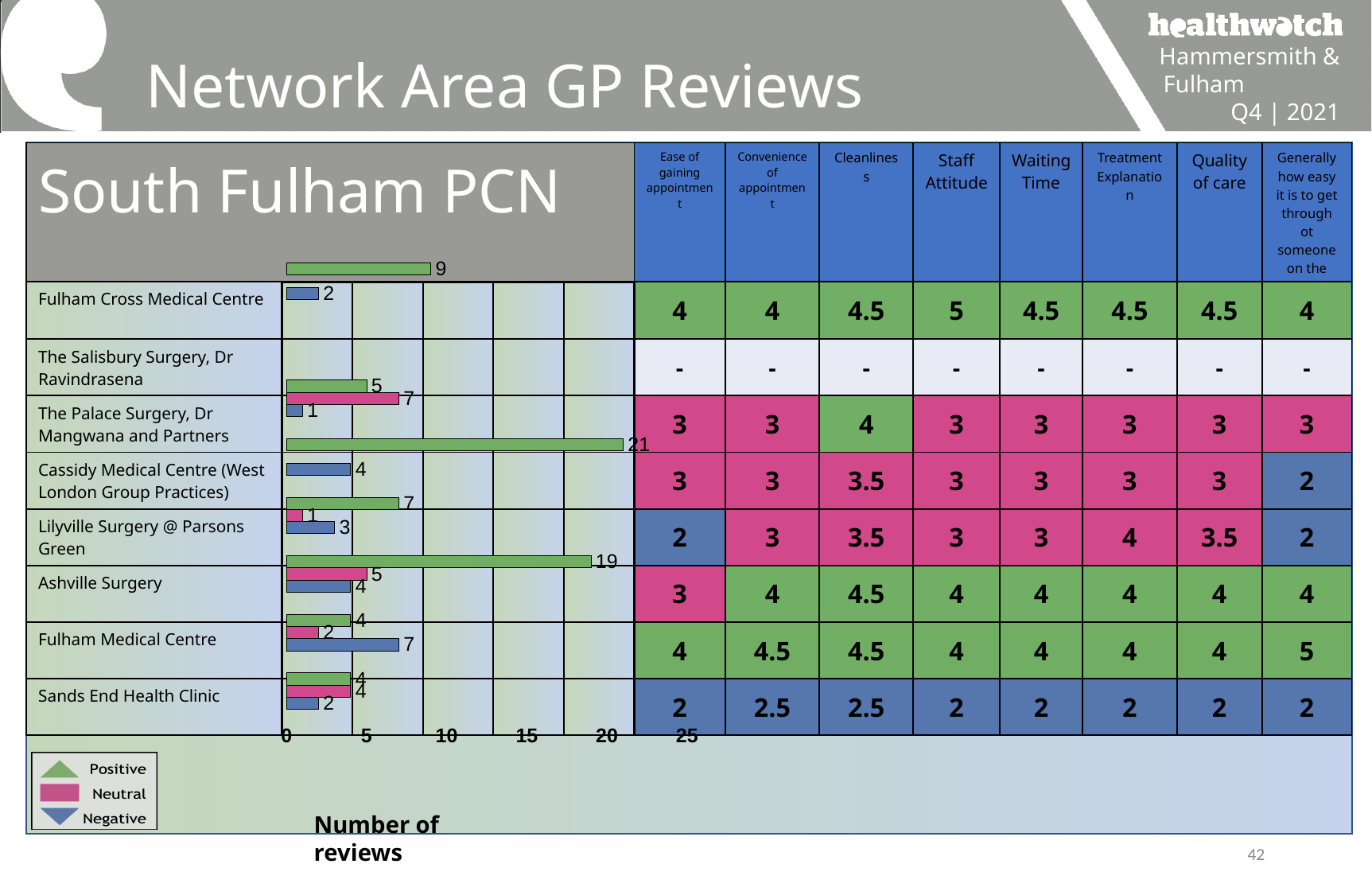
What is the difference between the two longest Positive bars, labelled 21 and 19? 2 What is the highest tick value shown on the horizontal axis of the bar chart? 25 Is the longest bar in the chart greater or less than 20? greater What is the largest value labelled on any bar in the chart? 21 What type of chart is shown on the left side of the South Fulham PCN slide? bar chart How many series does the legend of the bar chart list? 3 What is the smallest value labelled on any bar in the chart? 1 What is the Negative (blue) value shown for Sands End Health Clinic? 2 What is the title of the horizontal axis of the bar chart? Number of reviews Which is larger: the Positive bar labelled 21 or the Positive bar labelled 19? 21 What are the three series named in the bar chart legend? Positive, Neutral, Negative What is the value of the second-longest Positive (green) bar in the chart? 19